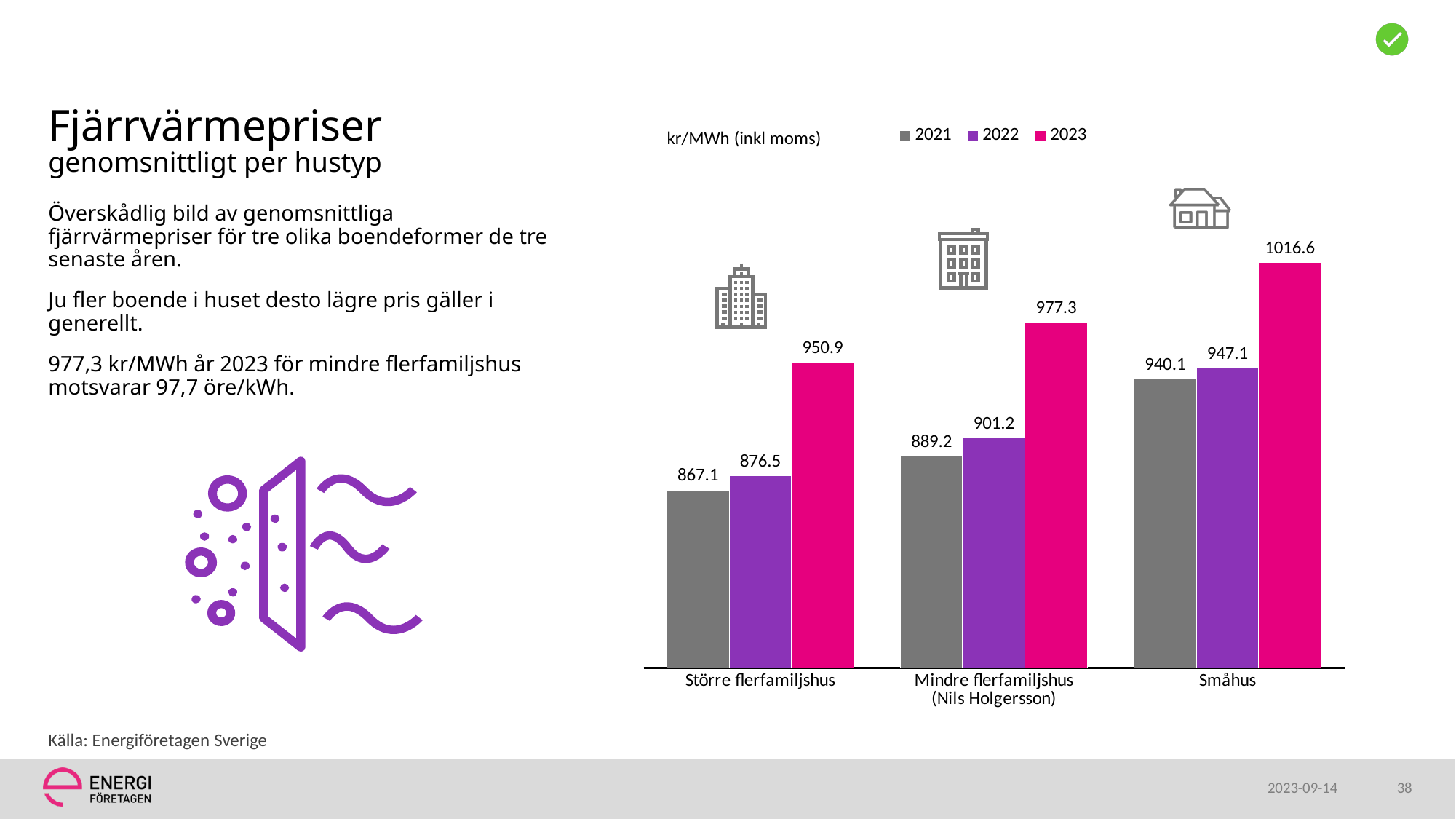
What is the 2021 value for Större flerfamiljshus? 867.1 Which is larger: the 2022 value for Småhus or the 2023 value for Större flerfamiljshus? 2023 value for Större flerfamiljshus What unit is shown above the chart? kr/MWh (inkl moms) How many series does the legend list? 3 Which category has the lowest 2021 value? Större flerfamiljshus What is the 2022 value for Mindre flerfamiljshus (Nils Holgersson)? 901.2 What is the difference between the 2023 values for Mindre flerfamiljshus (Nils Holgersson) and Större flerfamiljshus? 26.4 Which category has the highest 2023 value? Småhus What kind of chart is shown on the slide? Bar chart What is the 2023 value for Småhus? 1016.6 How many categories are shown on the x axis? 3 What is the difference between the 2023 and 2021 values for Småhus? 76.5